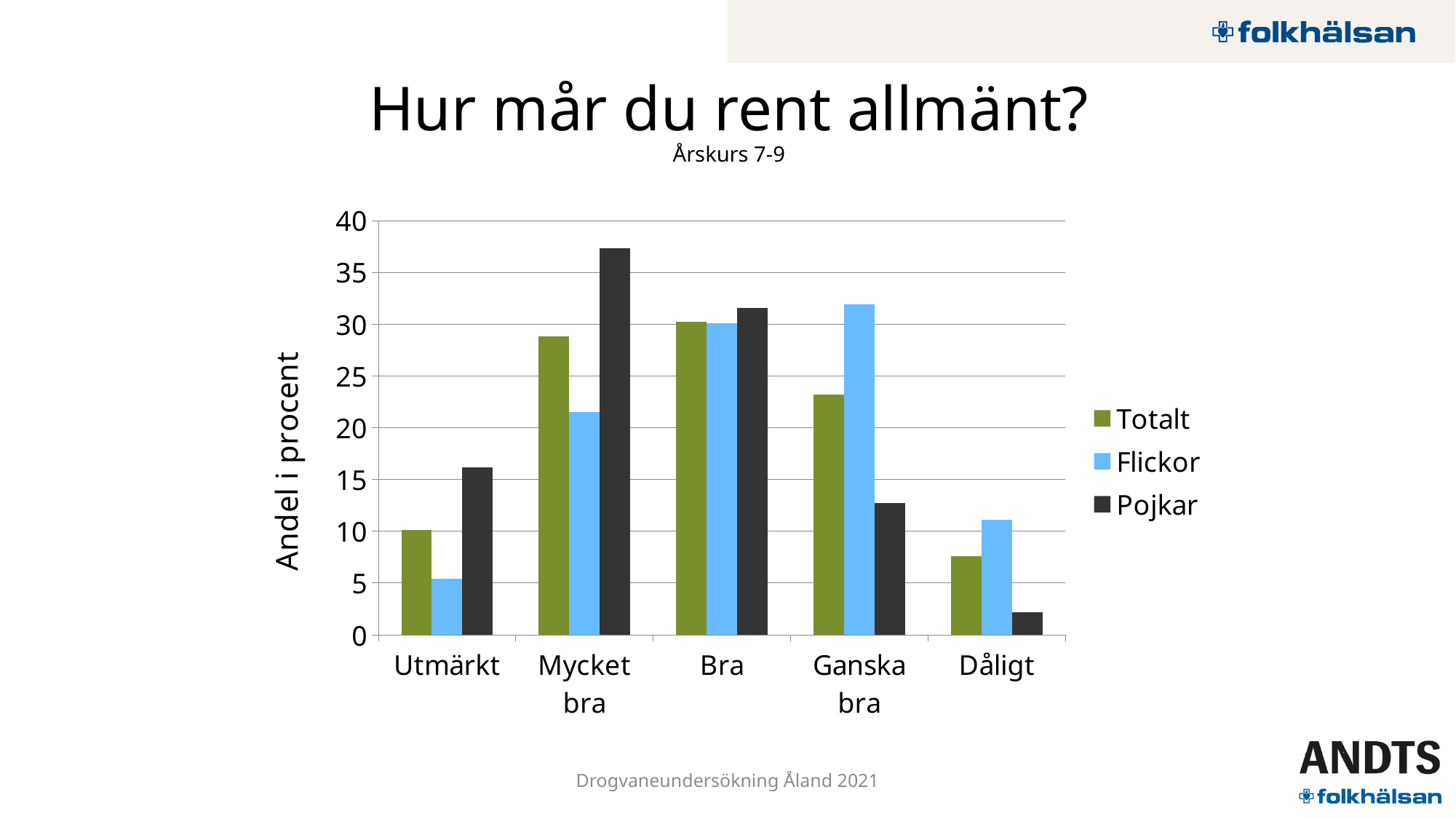
How many categories are shown on the x axis? 5 Is the Flickor value for Utmärkt greater or less than 10? less For which category is the Flickor value highest? Ganska bra What is the title of the y axis? Andel i procent How many series does the legend list? 3 For which category is the Flickor value lowest? Utmärkt For which category is the Pojkar value lowest? Dåligt For which category is the Pojkar value highest? Mycket bra For Utmärkt, which is larger: the Flickor value or the Pojkar value? Pojkar What kind of chart is shown on the slide? bar chart Is the Pojkar value for Mycket bra greater or less than 35? greater Is the Totalt value for Dåligt greater or less than 10? less